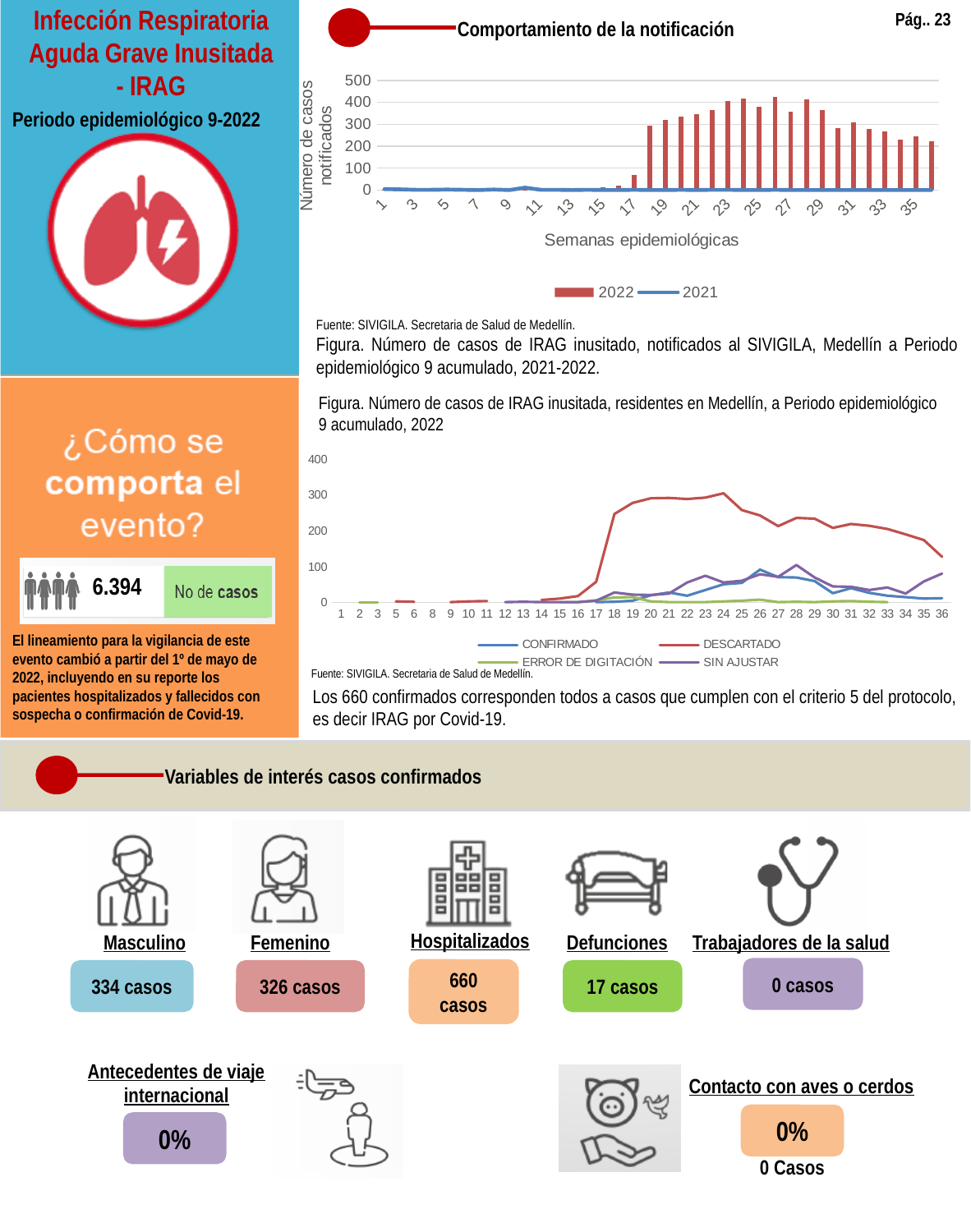
In the bottom line chart, how many epidemiological weeks are shown on the x axis? 34 In the top chart 'Comportamiento de la notificación', is the 2022 value for week 35 greater or less than 300? less In the top chart 'Comportamiento de la notificación', how many series does the legend list? 2 What kind of chart is the bottom chart showing CONFIRMADO, DESCARTADO, ERROR DE DIGITACIÓN and SIN AJUSTAR? line chart In the top chart 'Comportamiento de la notificación', which series has the larger value at week 25, 2022 or 2021? 2022 What kind of chart is the top chart titled 'Comportamiento de la notificación'? combination bar and line chart In the top chart 'Comportamiento de la notificación', is the 2022 value for week 24 greater or less than 300? greater In the top chart 'Comportamiento de la notificación', is the 2022 value for week 17 greater or less than 100? less In the bottom line chart, which series has the highest value at week 24? DESCARTADO In the bottom line chart, how many series does the legend list? 4 In the top chart 'Comportamiento de la notificación', do the 2022 values rise or fall from week 28 to week 36? fall